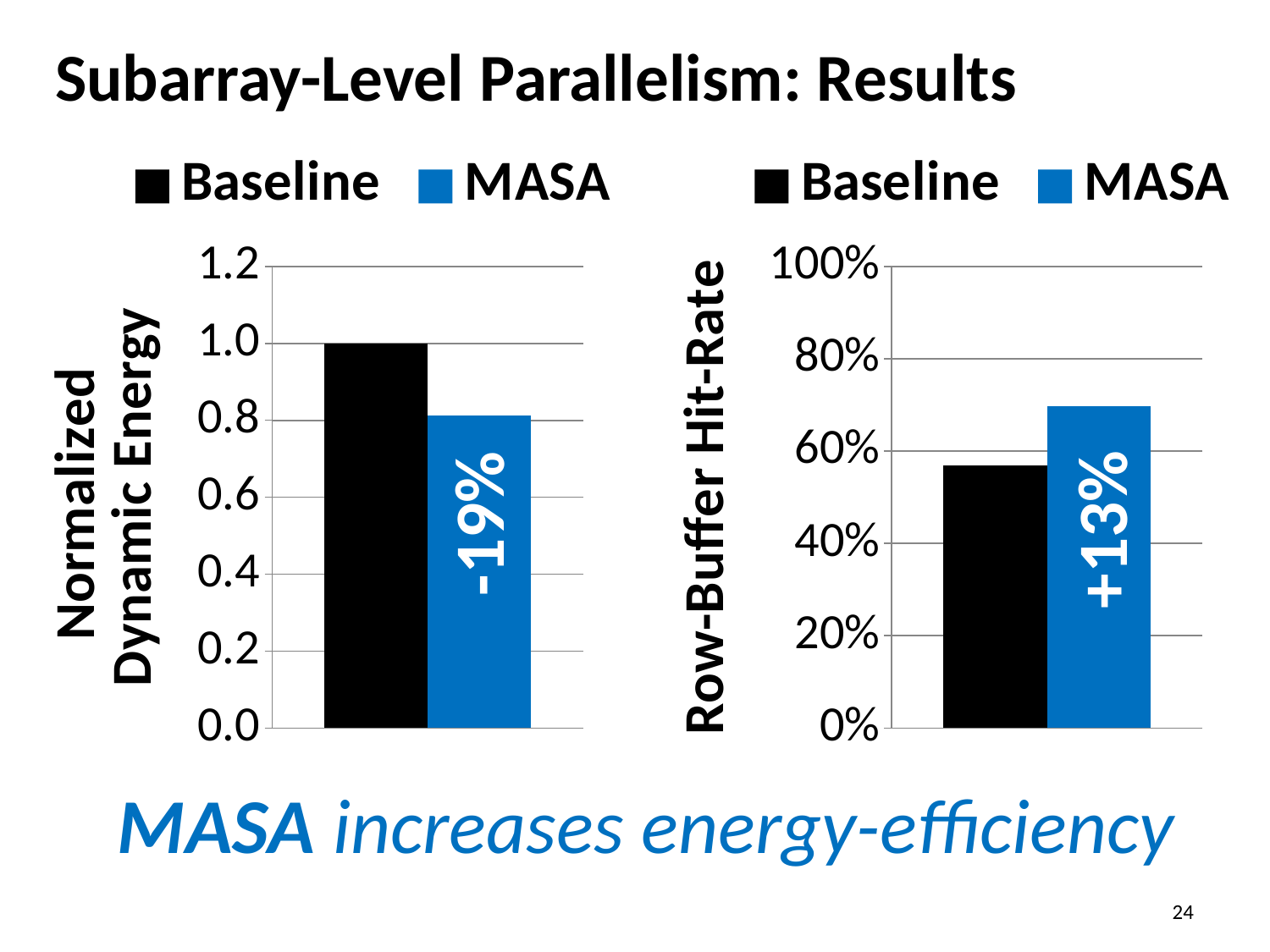
How many series does the legend of the Row-Buffer Hit-Rate chart list? 2 In the Row-Buffer Hit-Rate chart, what label is printed on the MASA bar? +13% In the Normalized Dynamic Energy chart, which series has the lower value? MASA In the Normalized Dynamic Energy chart, what colour is the MASA bar? blue In the Row-Buffer Hit-Rate chart, is the value for MASA greater or less than 80%? less What kind of chart is the Normalized Dynamic Energy chart? bar chart In the Row-Buffer Hit-Rate chart, is the value for Baseline greater or less than 40%? greater In the Row-Buffer Hit-Rate chart, is the value for MASA greater or less than 60%? greater In the Normalized Dynamic Energy chart, what is the value for Baseline? 1.0 In the Row-Buffer Hit-Rate chart, which series has the higher value? MASA In the Normalized Dynamic Energy chart, what label is printed on the MASA bar? -19%